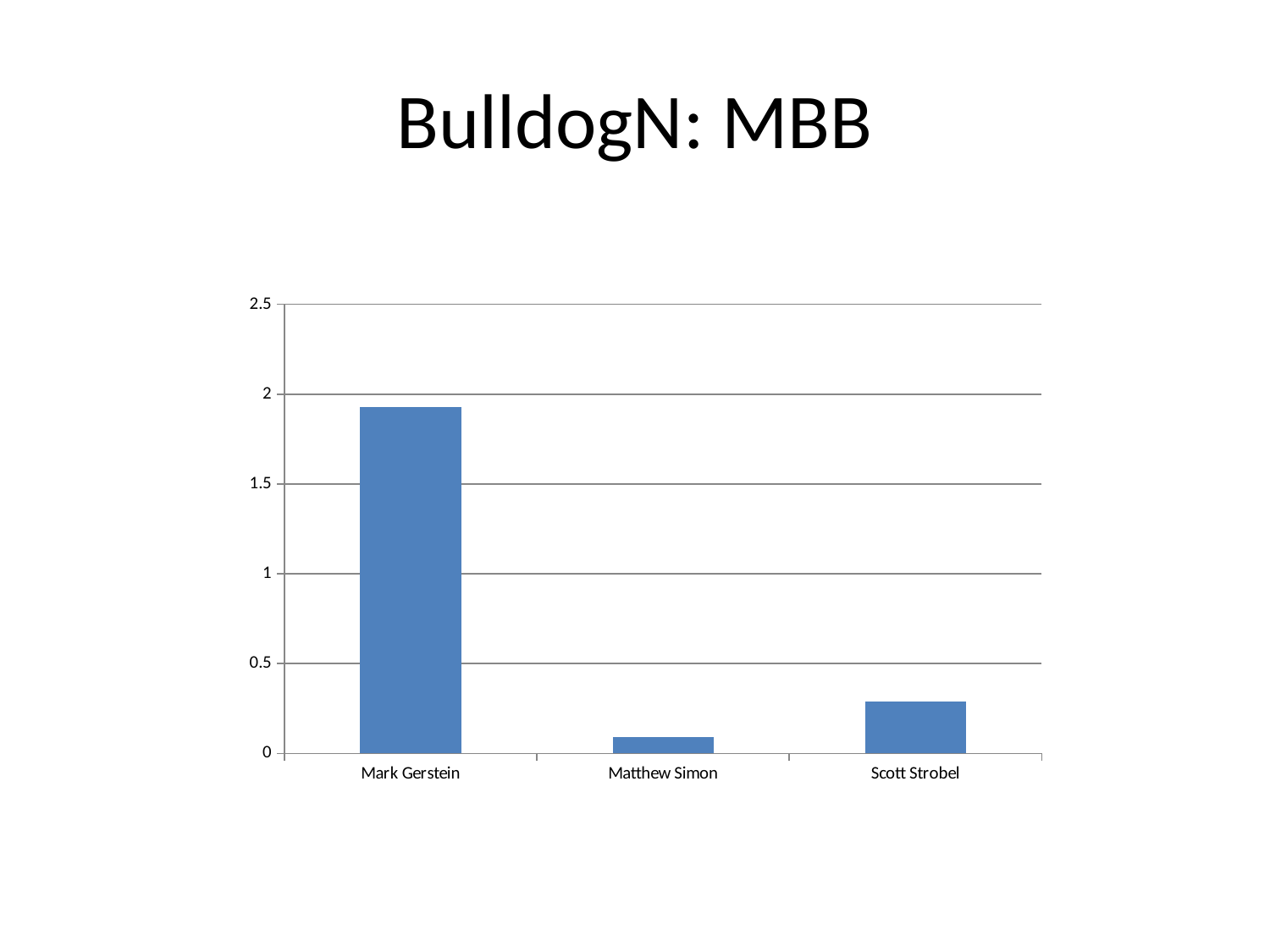
What kind of chart is shown on the slide? bar chart How many categories are shown on the x axis? 3 Which is larger, the value for Mark Gerstein or the value for Scott Strobel? Mark Gerstein Which category has the highest value? Mark Gerstein What is the title of the slide? BulldogN: MBB Which category has the lowest value? Matthew Simon What is the highest value shown on the y axis? 2.5 Which is larger, the value for Scott Strobel or the value for Matthew Simon? Scott Strobel Is the value for Mark Gerstein greater or less than 1.5? greater Is the value for Scott Strobel greater or less than 0.5? less Is the value for Mark Gerstein greater or less than 2? less